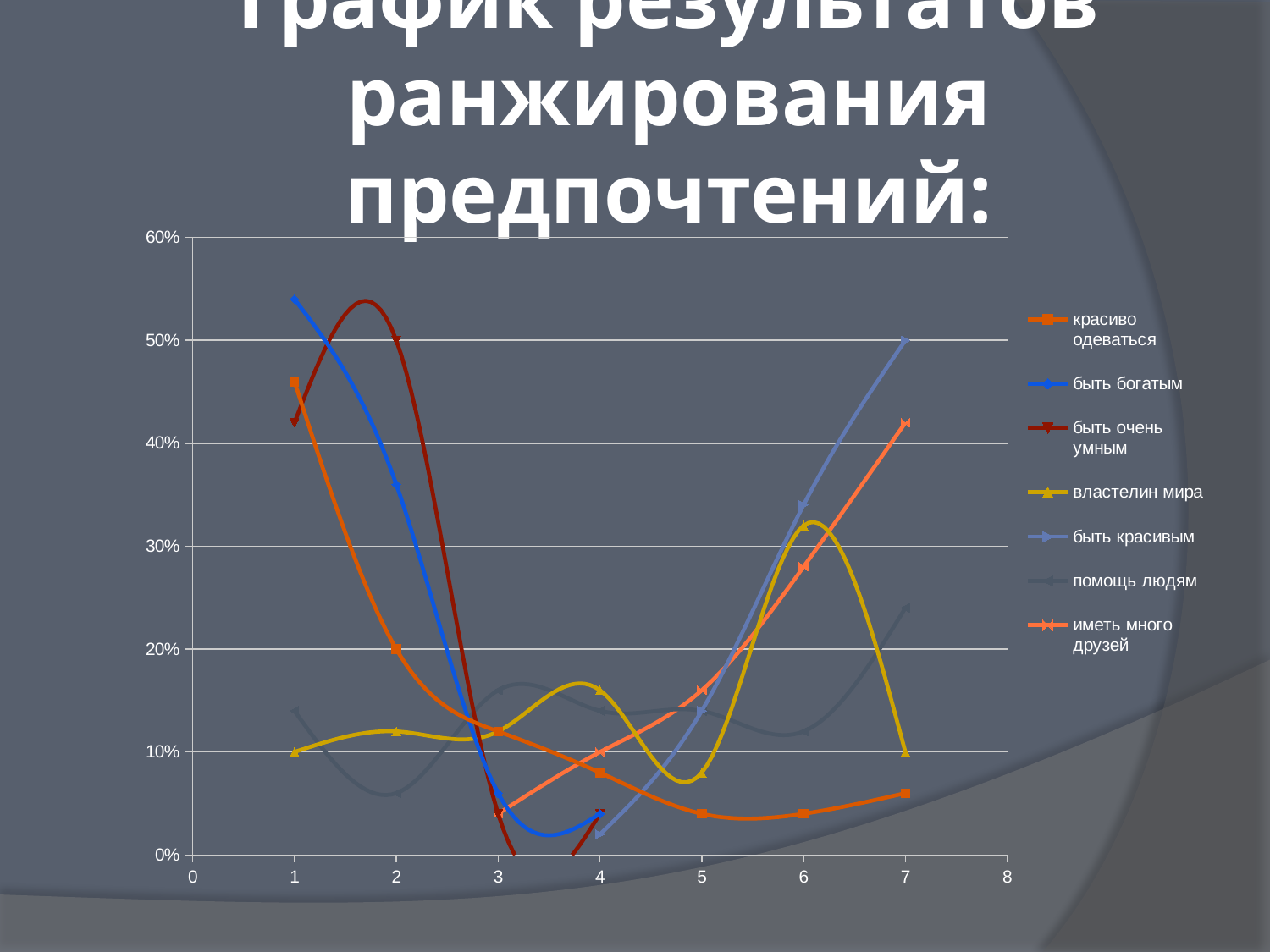
What is the difference between the "быть красивым" and "властелин мира" values at x = 7? 40% How many series does the legend list? 7 Does the "иметь много друзей" series rise or fall from x = 3 to x = 7? rise Is the value of the "помощь людям" series at x = 7 greater or less than 20%? greater What is the value of the "быть очень умным" series at x = 2? 50% What kind of chart is shown on the slide? line chart At x = 7, which is larger: "быть красивым" or "иметь много друзей"? быть красивым Which series has the highest value at x = 7? быть красивым What is the value of the "красиво одеваться" series at x = 2? 20% What is the value of the "властелин мира" series at x = 1? 10% Is the value of the "быть богатым" series at x = 1 greater or less than 50%? greater What is the value of the "быть красивым" series at x = 7? 50%